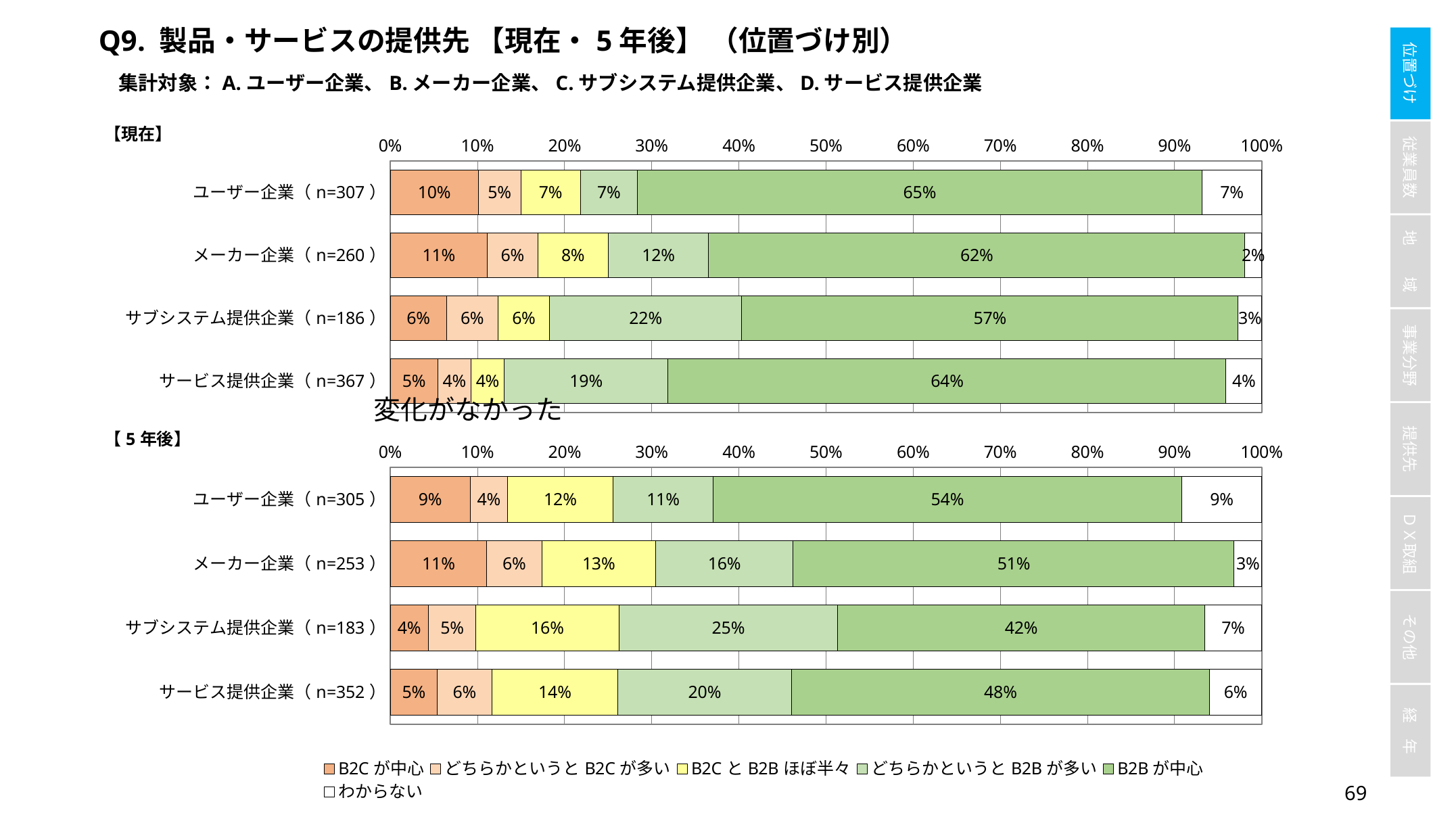
In the 【現在】 chart, what is the difference between the B2B が中心 values for メーカー企業（n=260）and サブシステム提供企業（n=186）? 5% How many categories are shown in the 【5年後】 chart? 4 In the 【5年後】 chart, what is the difference between the B2B が中心 values for メーカー企業（n=253）and サービス提供企業（n=352）? 3% In the 【5年後】 chart, which is larger: the B2C と B2B ほぼ半々 value for メーカー企業（n=253）or for ユーザー企業（n=305）? メーカー企業（n=253） How many series does the legend list? 6 Which legend entry is shown in white (unfilled)? わからない In the 【5年後】 chart, which category has the lowest value for B2B が中心? サブシステム提供企業（n=183） In the 【現在】 chart, what is the value of わからない for メーカー企業（n=260）? 2% In the 【5年後】 chart, what is the value of どちらかというと B2B が多い for サブシステム提供企業（n=183）? 25% In the 【現在】 chart, what is the value of B2B が中心 for ユーザー企業（n=307）? 65% In the 【現在】 chart, which category has the highest value for B2B が中心? ユーザー企業（n=307） What kind of chart is the 【現在】 chart? Stacked bar chart